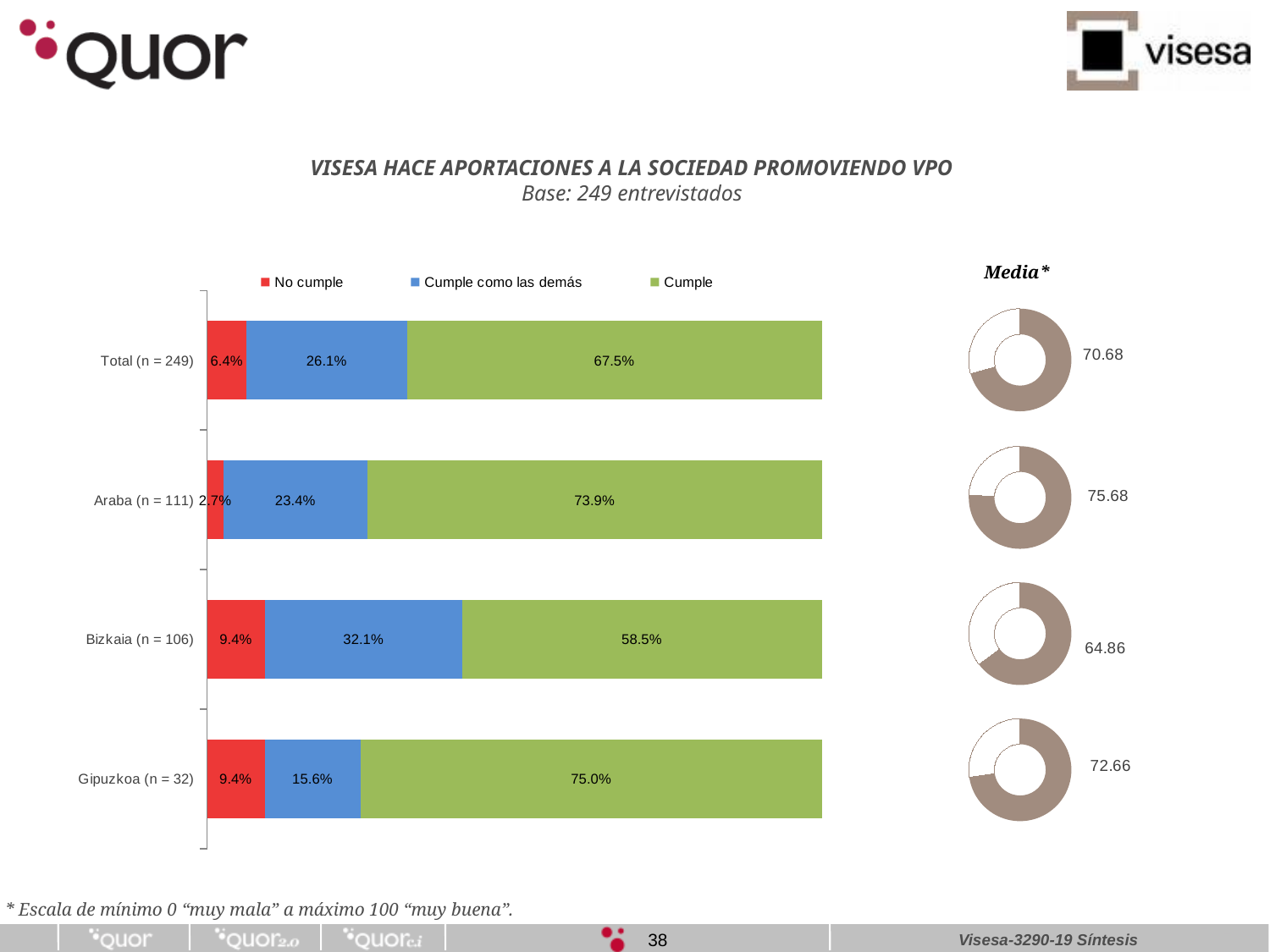
In the stacked bar chart, which is larger: the 'Cumple como las demás' value for Total (n = 249) or for Gipuzkoa (n = 32)? Total (n = 249) In the stacked bar chart, what is the 'No cumple' value for Araba (n = 111)? 2.7% In the 'Media*' donut charts on the right, which category has the highest value? Araba (n = 111) How many series does the legend of the stacked bar chart list? 3 In the stacked bar chart, what is the difference between the 'Cumple' values for Araba (n = 111) and Bizkaia (n = 106)? 15.4% In the 'Media*' donut charts on the right, what is the value shown for Bizkaia (n = 106)? 64.86 In the stacked bar chart, which category has the highest 'Cumple' value? Gipuzkoa (n = 32) What kind of chart is the main chart on the left of the slide? Stacked bar chart In the stacked bar chart, which category has the lowest 'Cumple' value? Bizkaia (n = 106) How many categories does the stacked bar chart show? 4 In the stacked bar chart, what is the 'Cumple' value for Total (n = 249)? 67.5% In the stacked bar chart, what is the 'Cumple como las demás' value for Bizkaia (n = 106)? 32.1%